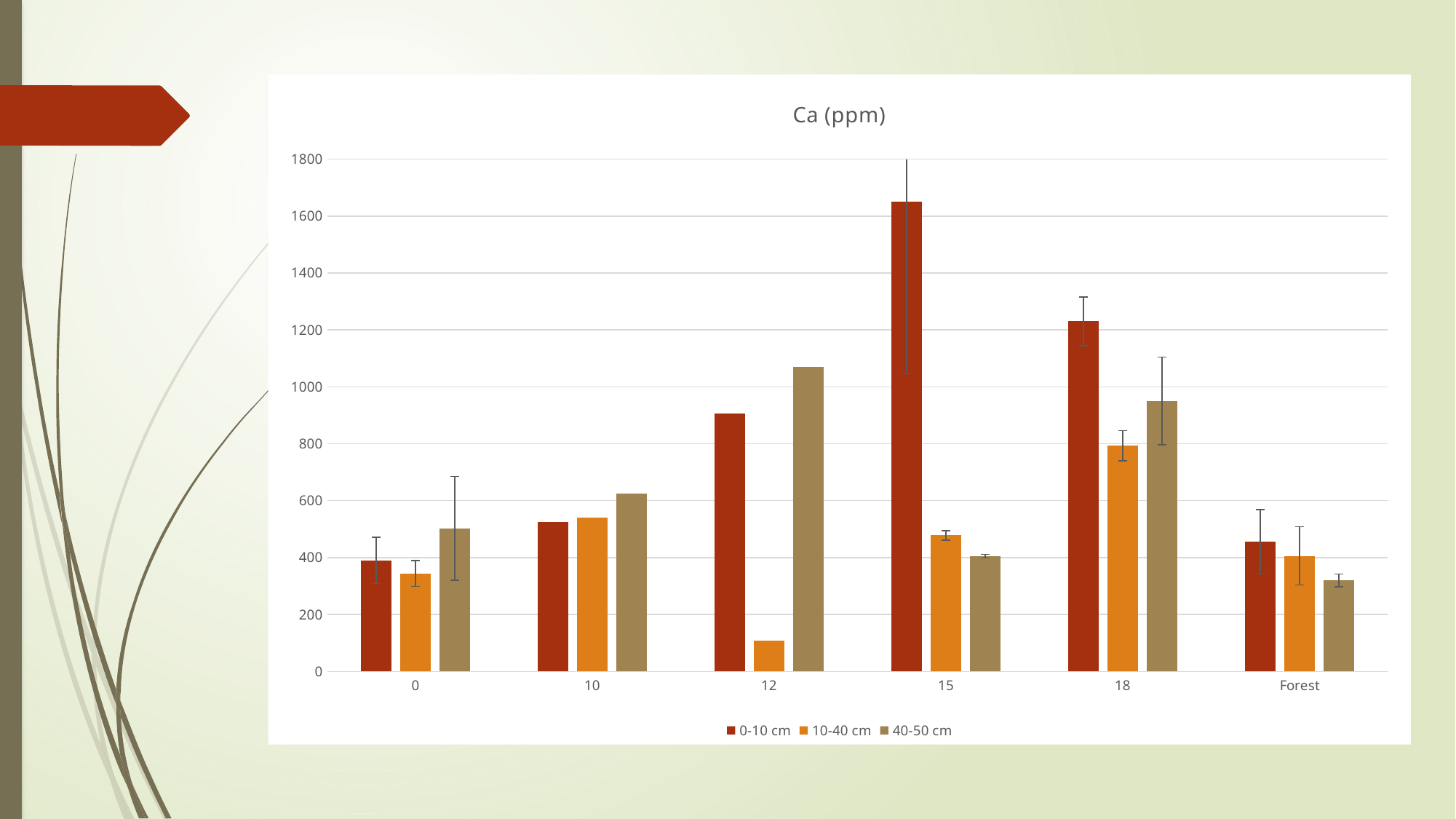
Is the value for the 0-10 cm series at category 15 greater or less than 1400? greater Is the value for the 40-50 cm series at category 18 greater or less than 1000? less How many series does the legend list? 3 At category 18, which series has the larger value: 0-10 cm or 40-50 cm? 0-10 cm Which category has the highest value for the 40-50 cm series? 12 Which category has the highest value for the 0-10 cm series? 15 At category 12, which series has the larger value: 0-10 cm or 40-50 cm? 40-50 cm What is the title of the chart? Ca (ppm) Is the value for the 10-40 cm series at category 12 greater or less than 200? less How many categories are shown on the x axis? 6 Which category has the lowest value for the 10-40 cm series? 12 What kind of chart is shown on the slide? bar chart